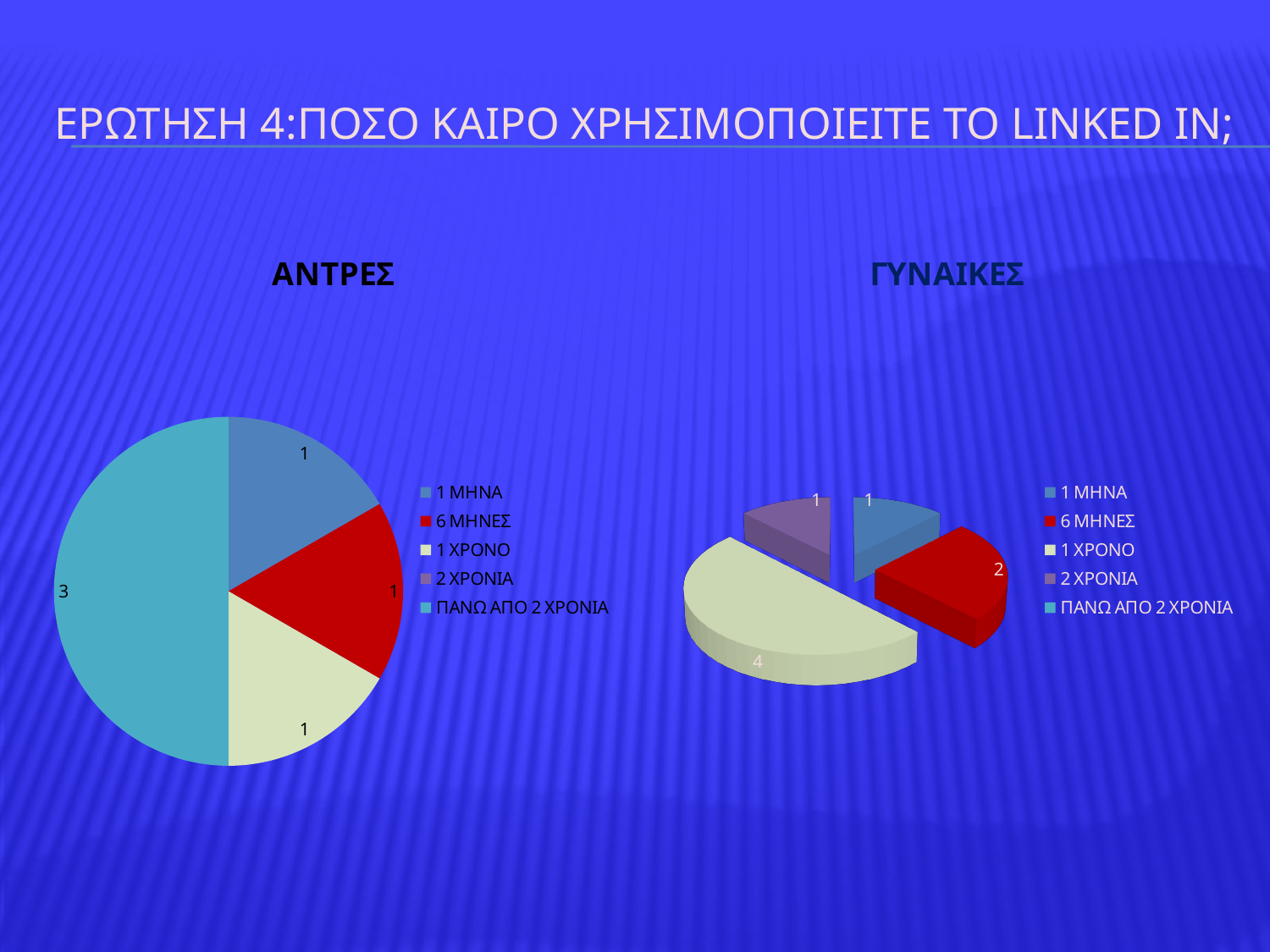
In the ΑΝΤΡΕΣ chart, which category has the largest slice? ΠΑΝΩ ΑΠΟ 2 ΧΡΟΝΙΑ In the ΑΝΤΡΕΣ chart, what is the value for 6 ΜΗΝΕΣ? 1 In the ΓΥΝΑΙΚΕΣ chart, what is the difference between the values for 1 ΧΡΟΝΟ and 6 ΜΗΝΕΣ? 2 In the ΑΝΤΡΕΣ chart, what is the value for ΠΑΝΩ ΑΠΟ 2 ΧΡΟΝΙΑ? 3 In the ΓΥΝΑΙΚΕΣ chart, which is larger: 6 ΜΗΝΕΣ or 2 ΧΡΟΝΙΑ? 6 ΜΗΝΕΣ What is the title of the chart on the right side of the slide? ΓΥΝΑΙΚΕΣ In the ΓΥΝΑΙΚΕΣ chart, what is the value for 1 ΧΡΟΝΟ? 4 In the ΓΥΝΑΙΚΕΣ chart, which category has the largest slice? 1 ΧΡΟΝΟ How many entries does the legend of the ΑΝΤΡΕΣ chart list? 5 In the ΓΥΝΑΙΚΕΣ chart, what is the value for 6 ΜΗΝΕΣ? 2 What kind of chart is the ΓΥΝΑΙΚΕΣ chart? Pie chart In the ΑΝΤΡΕΣ chart, what share of the pie does ΠΑΝΩ ΑΠΟ 2 ΧΡΟΝΙΑ represent? 50%